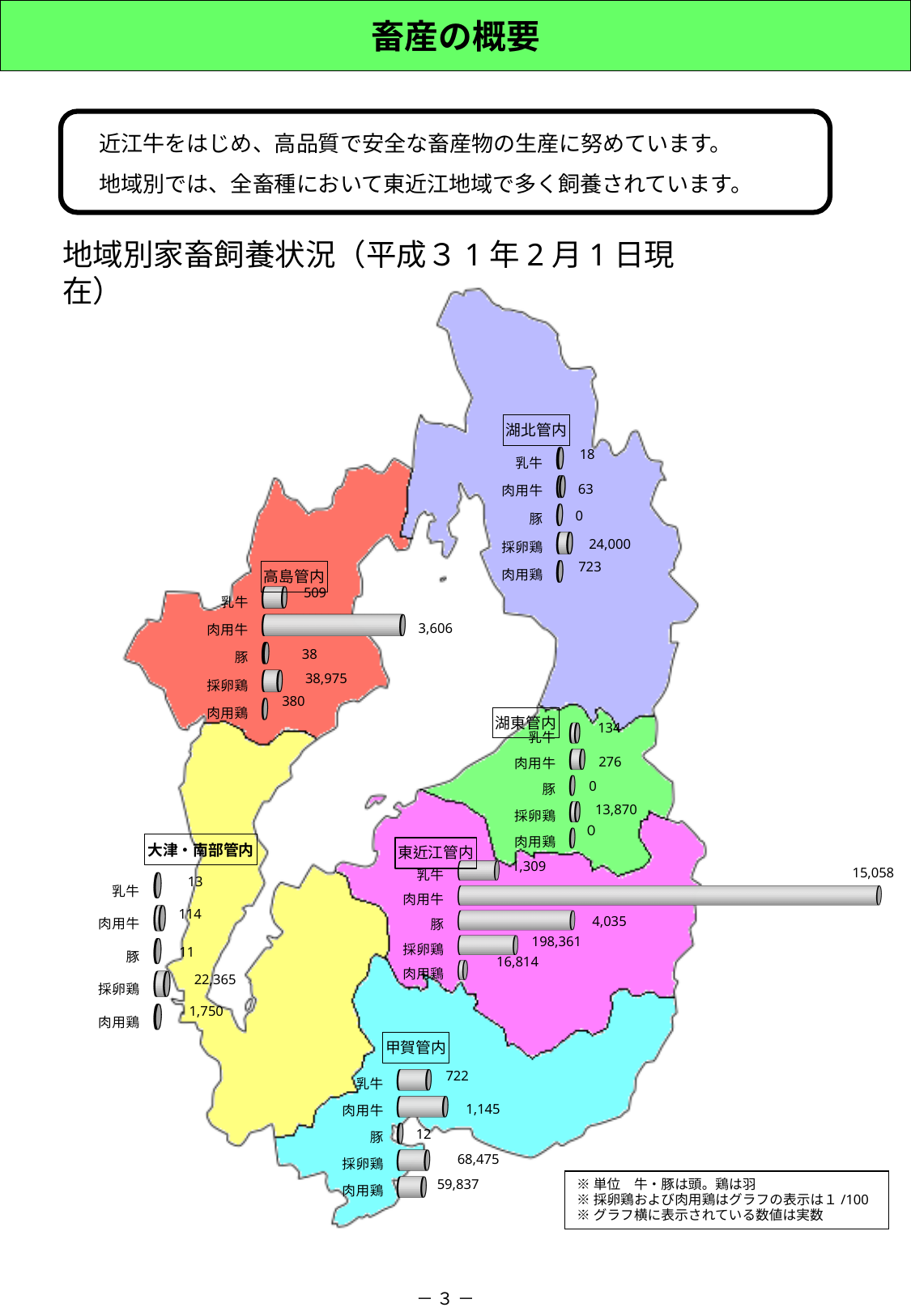
In the 湖北管内 chart, what is the value for 乳牛? 18 In the 大津・南部管内 chart, what is the value for 採卵鶏? 22,365 In the 東近江管内 chart, which category has the lowest value? 乳牛 In the 甲賀管内 chart, what is the value for 肉用鶏? 59,837 How many categories does the 湖北管内 chart show? 5 In the 高島管内 chart, what is the value for 採卵鶏? 38,975 In the 甲賀管内 chart, what is the difference between 肉用牛 and 乳牛? 423 What kind of chart is used for each region on the slide? bar chart How many regional charts are shown on the map? 6 In the 高島管内 chart, which is larger, 肉用牛 or 乳牛? 肉用牛 In the 湖東管内 chart, which category has the highest value? 採卵鶏 In the 東近江管内 chart, what is the value for 肉用牛? 15,058